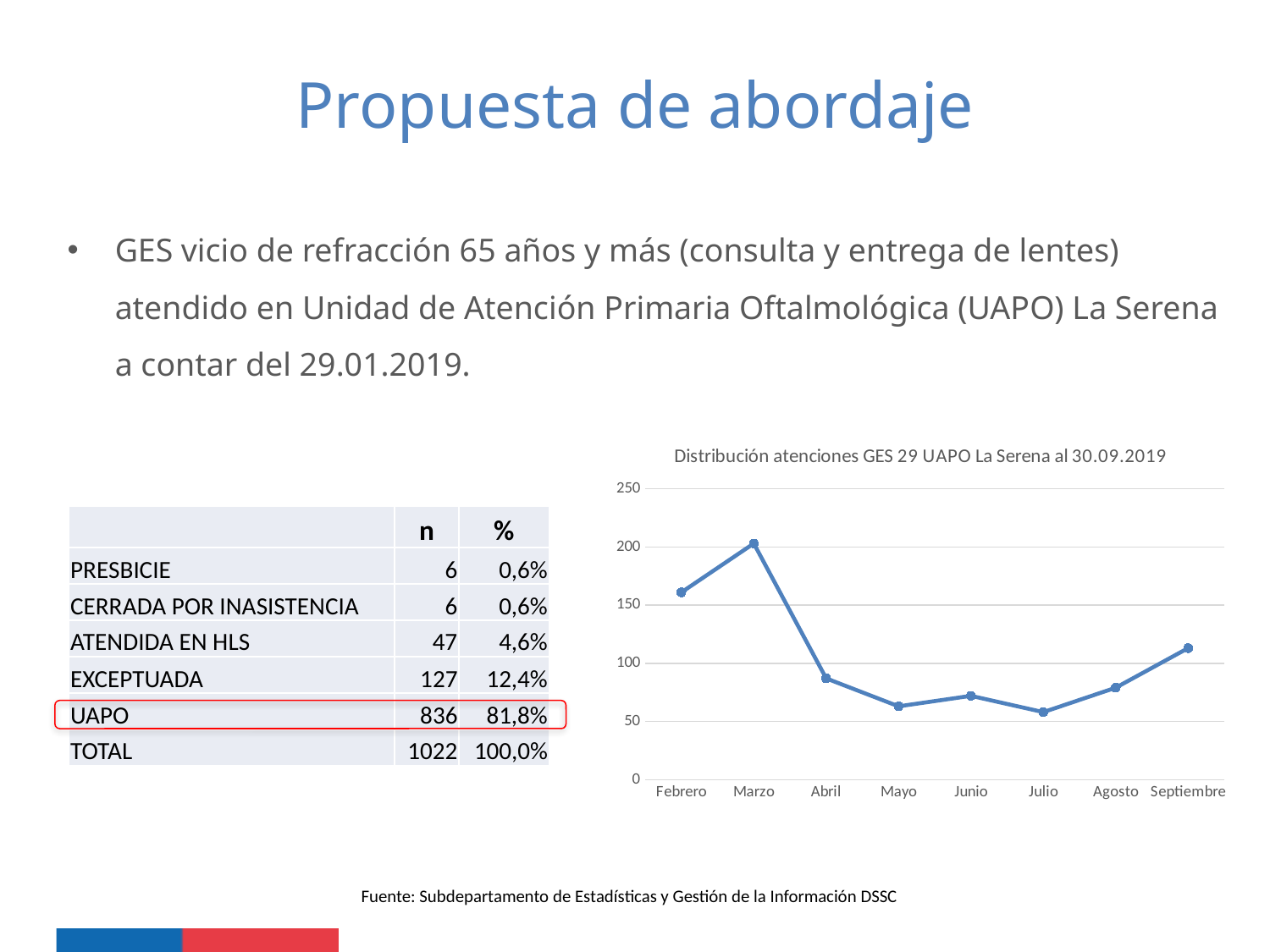
Which is larger, the value for Febrero or the value for Septiembre? Febrero Is the value for Julio greater or less than 100? less How many months are plotted on the x axis of the chart? 8 Is the value for Abril greater or less than 100? less Which is larger, the value for Agosto or the value for Abril? Abril Which month has the highest value in the chart? Marzo Is the value for Febrero greater or less than 150? greater Do the values rise or fall from Marzo to Abril? fall What kind of chart is shown on the slide? line chart What is the title of the chart? Distribución atenciones GES 29 UAPO La Serena al 30.09.2019